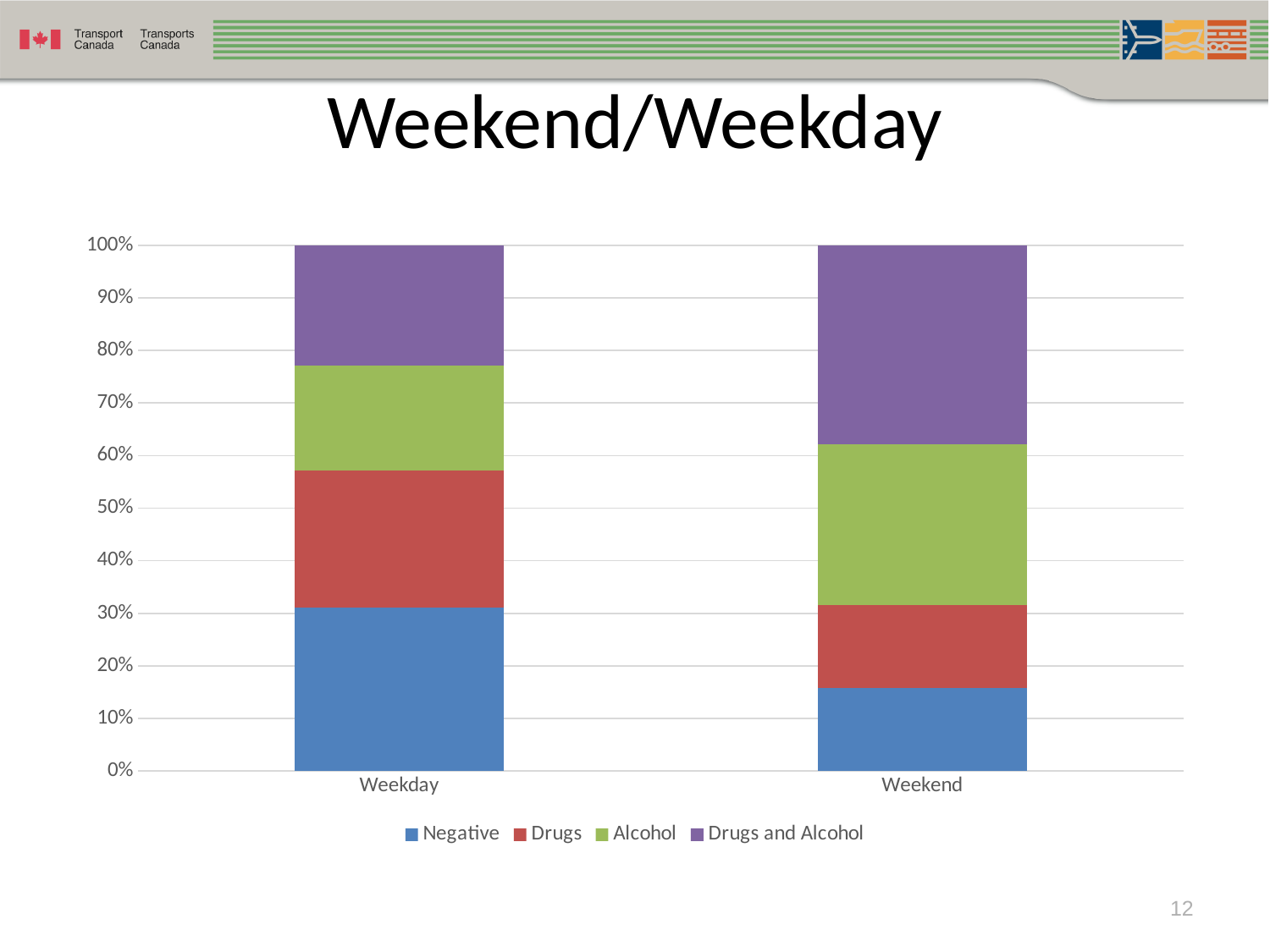
Which series has the largest share in the Weekend bar? Drugs and Alcohol How many categories are shown on the x axis? 2 Is the Negative share for Weekend greater or less than 20%? less Is the Drugs and Alcohol share larger for Weekday or Weekend? Weekend Is the Negative share larger for Weekday or Weekend? Weekday Is the Drugs and Alcohol share for Weekend greater or less than 30%? greater Is the Alcohol share larger for Weekday or Weekend? Weekend What is the title of the slide? Weekend/Weekday How many series does the legend list? 4 Which series is shown in purple in the legend? Drugs and Alcohol What kind of chart is shown on the slide? Stacked bar chart Is the Negative share for Weekday greater or less than 20%? greater